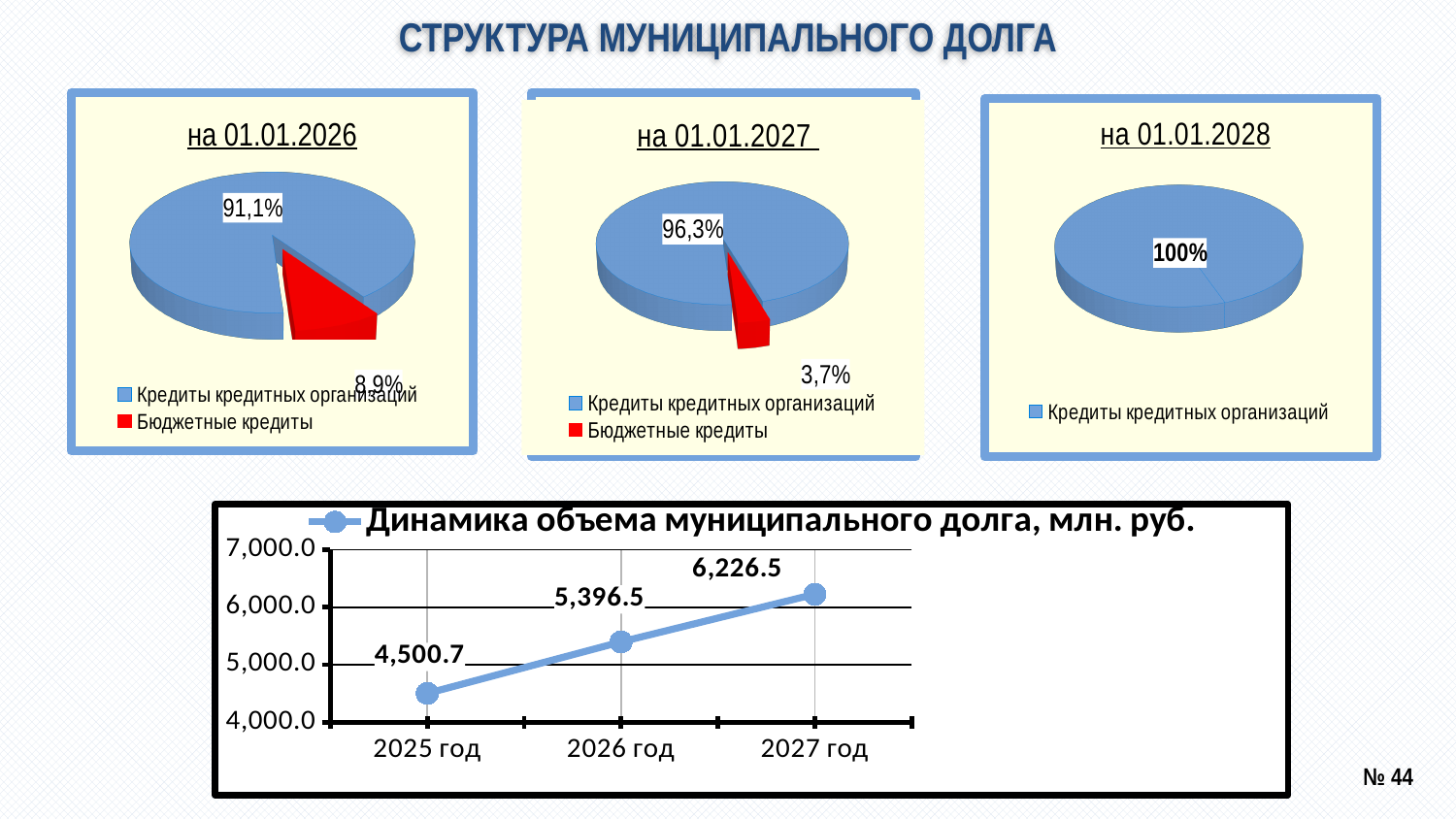
In the chart 'Динамика объема муниципального долга, млн. руб.', do the values rise or fall from 2025 год to 2027 год? rise In the pie chart 'на 01.01.2028', what share is shown for Кредиты кредитных организаций? 100% How many legend entries does the pie chart 'на 01.01.2028' list? 1 In the pie chart 'на 01.01.2026', by how many percentage points does Кредиты кредитных организаций exceed Бюджетные кредиты? 82,2% In the chart 'Динамика объема муниципального долга, млн. руб.', what is the value for 2026 год? 5,396.5 In the chart 'Динамика объема муниципального долга, млн. руб.', what is the difference between the values for 2027 год and 2025 год? 1,725.8 In the pie chart 'на 01.01.2026', what share is shown for Кредиты кредитных организаций? 91,1% In the pie chart 'на 01.01.2027', what share is shown for Бюджетные кредиты? 3,7% What kind of chart is 'Динамика объема муниципального долга, млн. руб.'? line chart In the chart 'Динамика объема муниципального долга, млн. руб.', what is the value for 2025 год? 4,500.7 In the pie chart 'на 01.01.2027', which category has the larger share? Кредиты кредитных организаций